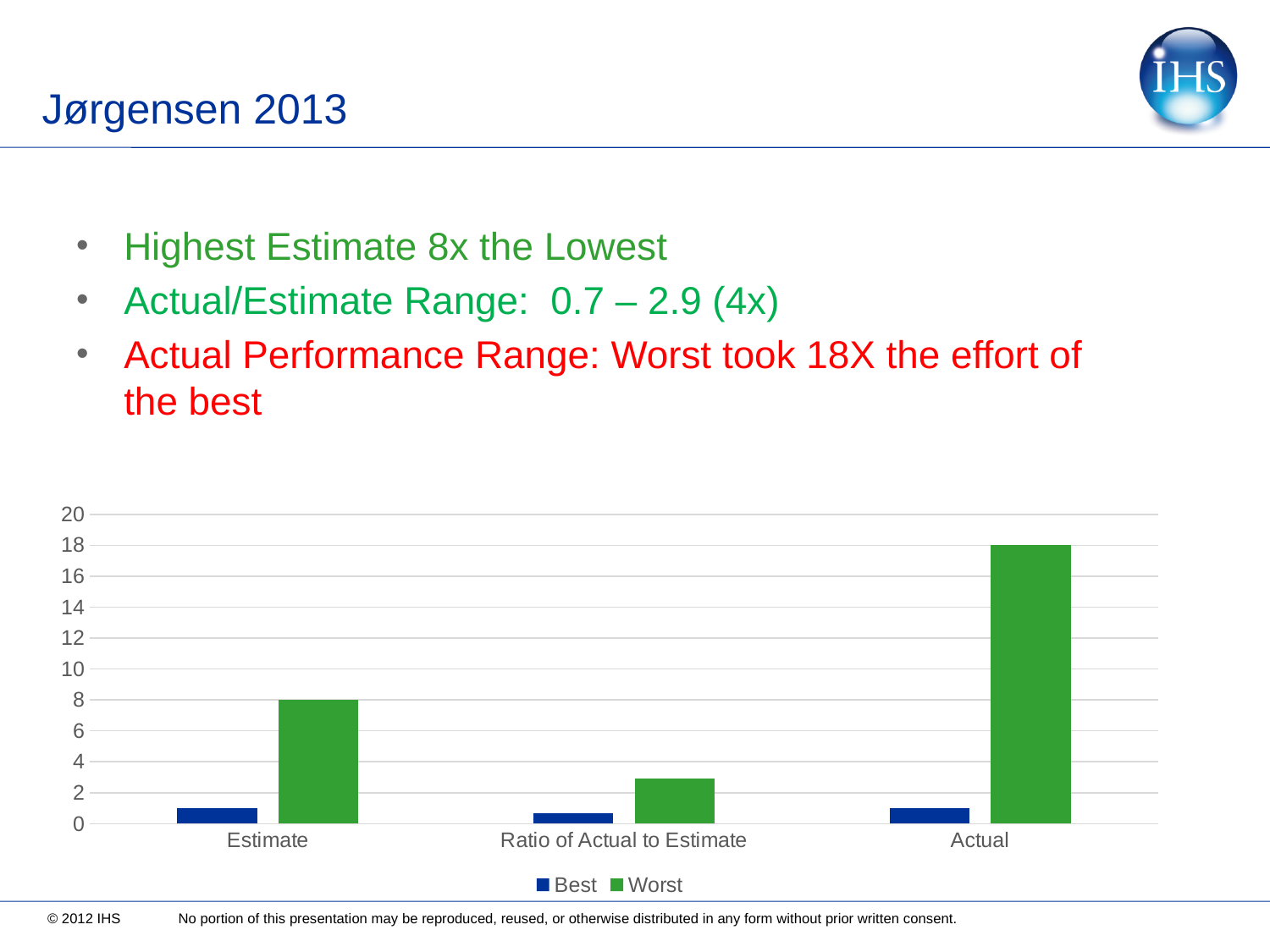
Is the Worst value for Ratio of Actual to Estimate greater or less than 4? less What is the difference between the Worst value for Actual and the Worst value for Estimate? 10 Which category has the highest Worst value? Actual How many series does the chart legend list? 2 What is the Worst value for Actual? 18 Which is larger, the Worst value for Estimate or the Worst value for Actual? Actual Is the Best value for Actual greater or less than 2? less How many categories are shown on the x axis of the chart? 3 What colour represents the Worst series in the chart? green Which category has the lowest Worst value? Ratio of Actual to Estimate What kind of chart is shown on the slide? bar chart What is the Worst value for Estimate? 8